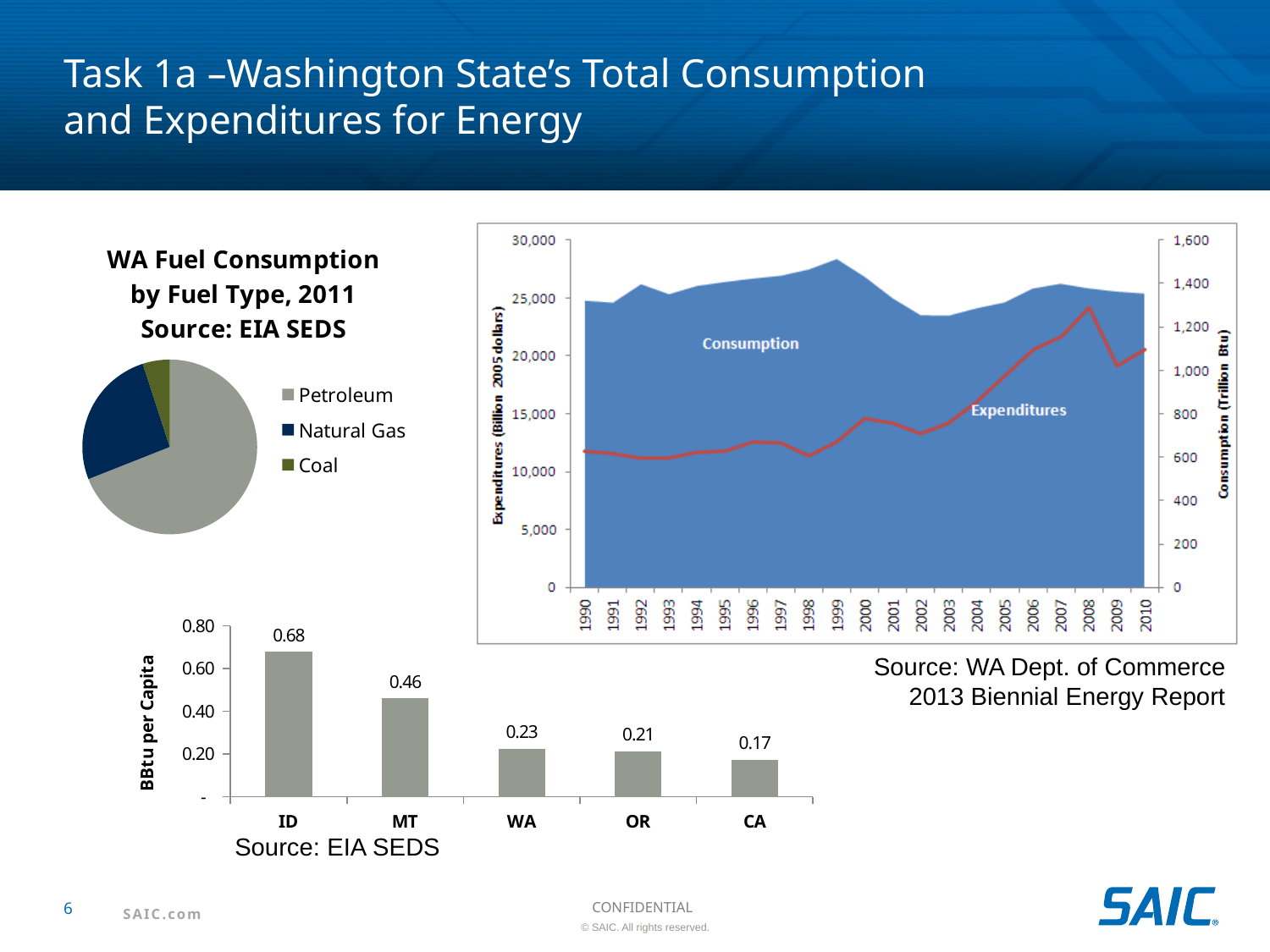
In the chart at the top right showing Consumption and Expenditures, does the Expenditures line generally rise or fall from 1990 to 2008? rise In the chart at the top right showing Consumption and Expenditures, is the Expenditures value for 2008 greater or less than 20,000? greater In the bar chart of BBtu per Capita, what is the value for ID? 0.68 In the bar chart of BBtu per Capita, what is the value for WA? 0.23 In the bar chart of BBtu per Capita, what is the difference between the values for ID and MT? 0.22 In the bar chart of BBtu per Capita, which is larger, the value for OR or the value for CA? OR In the pie chart titled 'WA Fuel Consumption by Fuel Type, 2011', which fuel type has the largest slice? Petroleum In the pie chart titled 'WA Fuel Consumption by Fuel Type, 2011', which fuel type has the smallest slice? Coal In the bar chart of BBtu per Capita, how many states are shown? 5 In the bar chart of BBtu per Capita, which state has the lowest value? CA In the bar chart of BBtu per Capita, which state has the highest value? ID In the pie chart titled 'WA Fuel Consumption by Fuel Type, 2011', how many fuel types does the legend list? 3